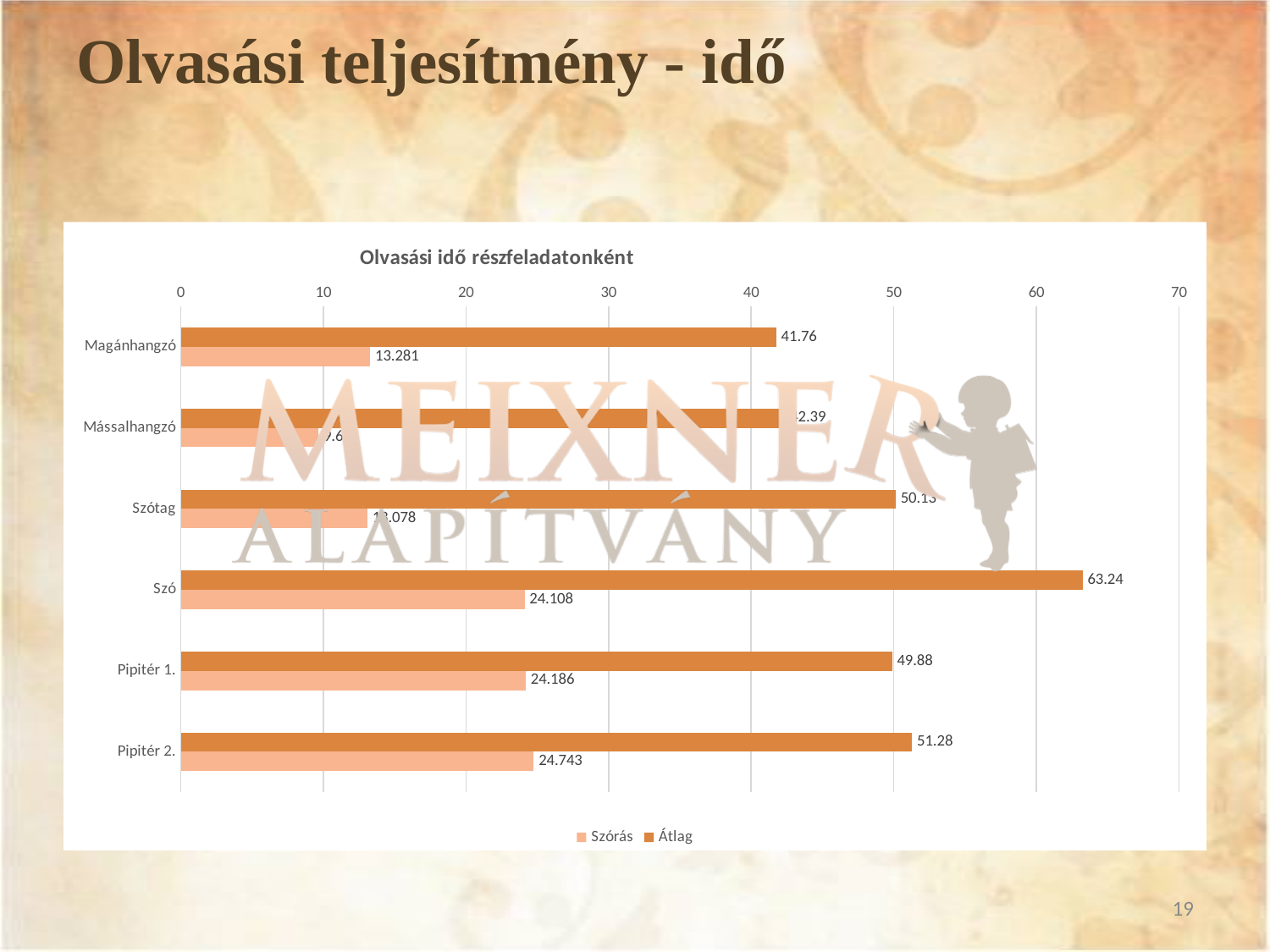
What is the Átlag value for Szó? 63.24 What is the difference between the Átlag and Szórás values for Szó? 39.132 How many series does the legend list? 2 What is the title of the chart? Olvasási idő részfeladatonként Is the Átlag value for Mássalhangzó greater or less than 40? greater What is the Szórás value for Pipitér 2.? 24.743 How many categories are shown on the chart? 6 What type of chart is shown on the slide? bar chart Which category has the lowest Szórás value? Mássalhangzó What is the Szórás value for Magánhangzó? 13.281 Which category has the highest Átlag value? Szó What is the Átlag value for Pipitér 1.? 49.88